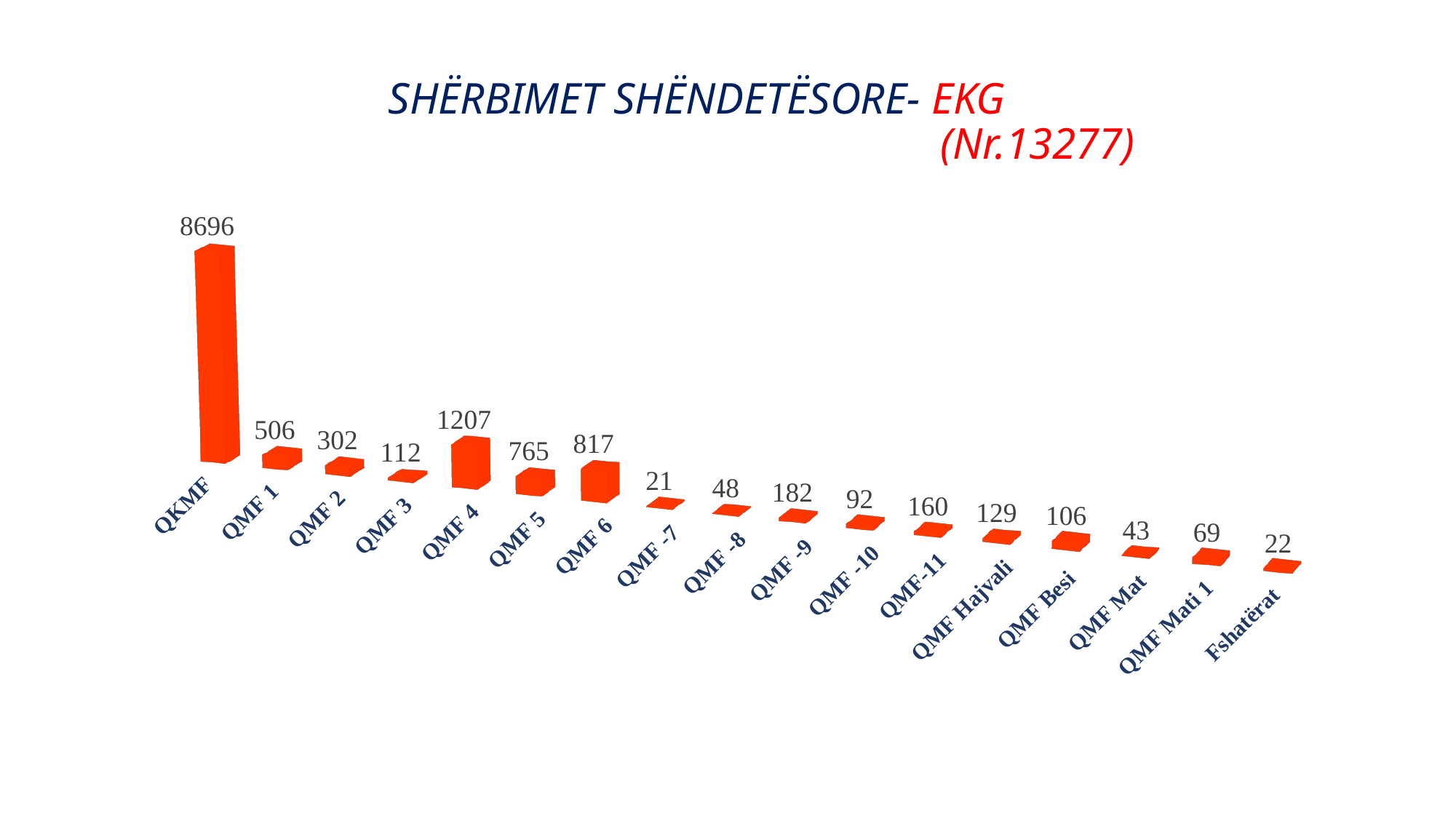
What is the difference between the values for QMF 6 and QMF 5? 52 What is the value for Fshatërat? 22 What is the value for QMF 4? 1207 How many categories are shown in the chart? 17 What is the value for QKMF? 8696 What is the value for QMF Hajvali? 129 What is the difference between the values for QMF 4 and QMF 1? 701 Which is larger, the value for QMF -9 or the value for QMF -10? QMF -9 What kind of chart is shown on the slide? Bar chart What total number is given in the chart title? Nr.13277 Which category has the highest value? QKMF Which is larger, the value for QMF 2 or the value for QMF 3? QMF 2